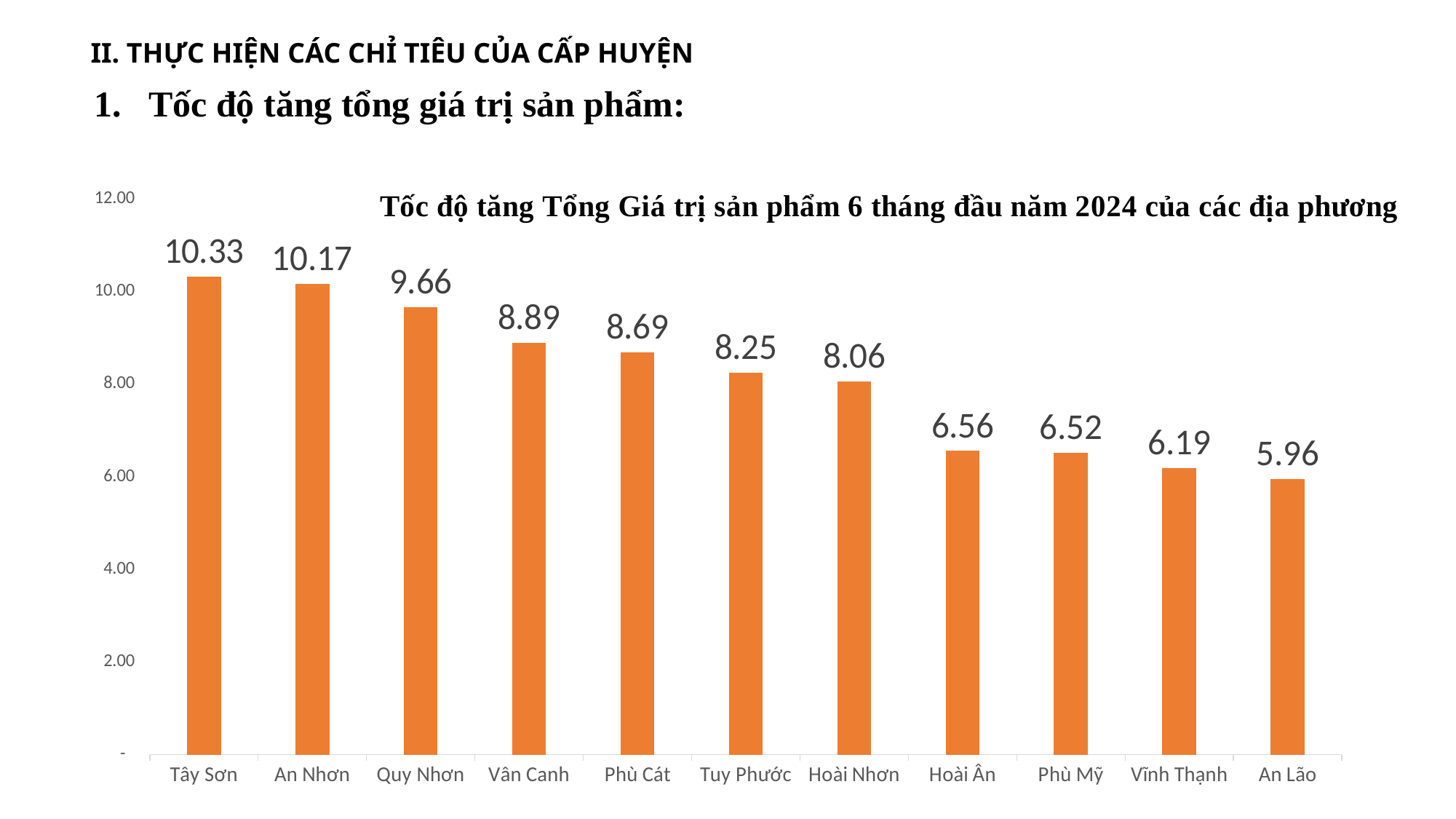
Do the values rise or fall from left to right along the x axis? fall Which locality has the lowest value? An Lão What is the difference between the values for Quy Nhơn and Vân Canh? 0.77 How many localities are shown on the chart? 11 Which is larger, the value for Phù Cát or the value for Tuy Phước? Phù Cát What kind of chart is shown on the slide? bar chart Is the value for Vĩnh Thạnh greater or less than 8.00? less What is the value for Tây Sơn? 10.33 What is the value for Hoài Nhơn? 8.06 What is the value for An Lão? 5.96 What is the difference between the values for Tây Sơn and An Lão? 4.37 Which locality has the highest value? Tây Sơn